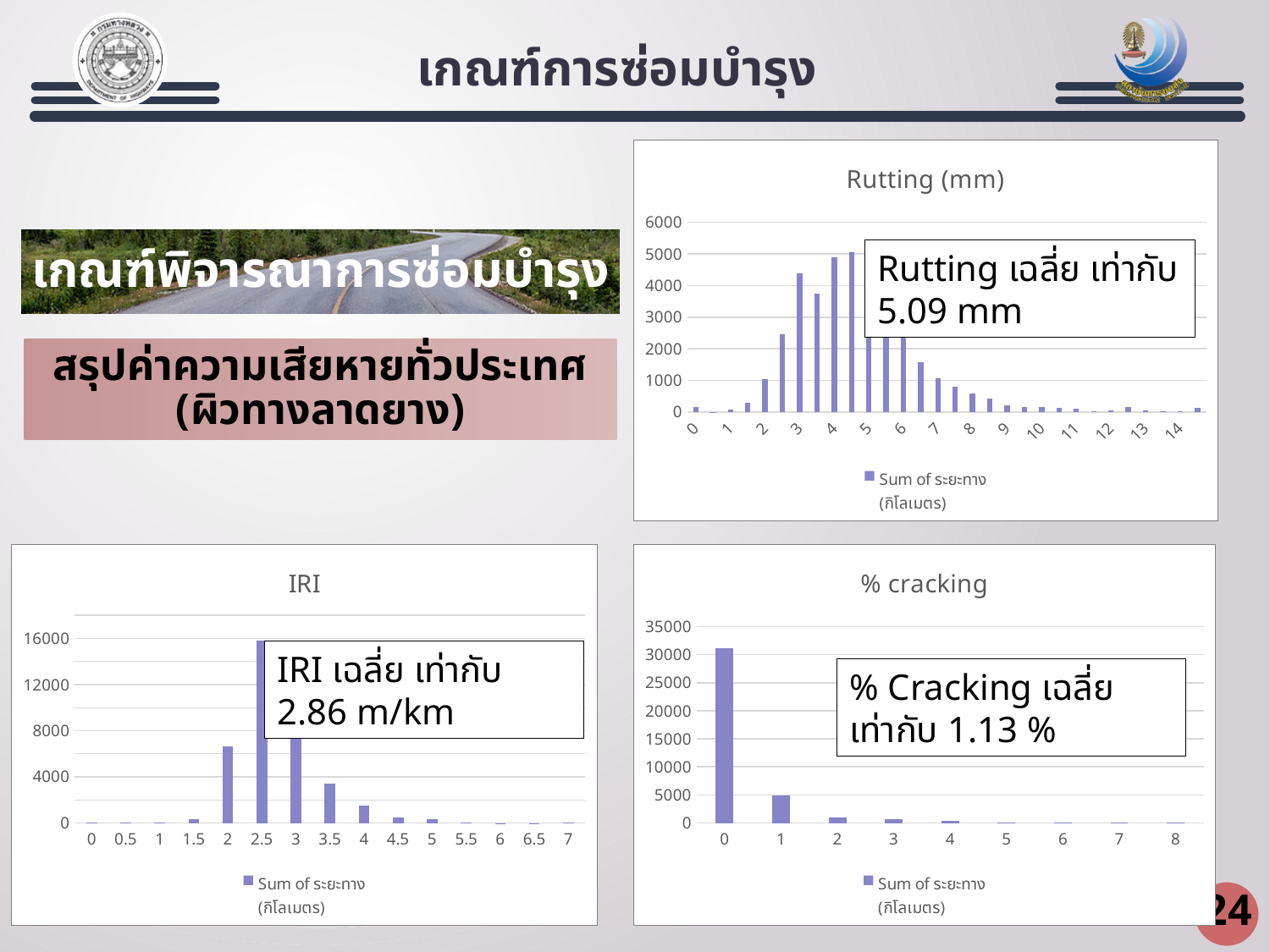
What kind of chart is the 'Rutting (mm)' chart? bar chart In the 'IRI' chart, which is larger, the value for 2.5 or the value for 3? 2.5 In the 'IRI' chart, is the value for 2 greater or less than 4000? greater What is the legend entry shown on the 'IRI' chart? Sum of ระยะทาง (กิโลเมตร) In the '% cracking' chart, do the values rise or fall from category 0 to category 8? fall In the '% cracking' chart, is the value for 0 greater or less than 30000? greater In the 'Rutting (mm)' chart, is the value for 3 greater or less than 4000? greater How many series does the legend of the '% cracking' chart list? 1 In the 'IRI' chart, which category has the highest value? 2.5 In the '% cracking' chart, which is larger, the value for 0 or the value for 1? 0 In the '% cracking' chart, which category has the highest value? 0